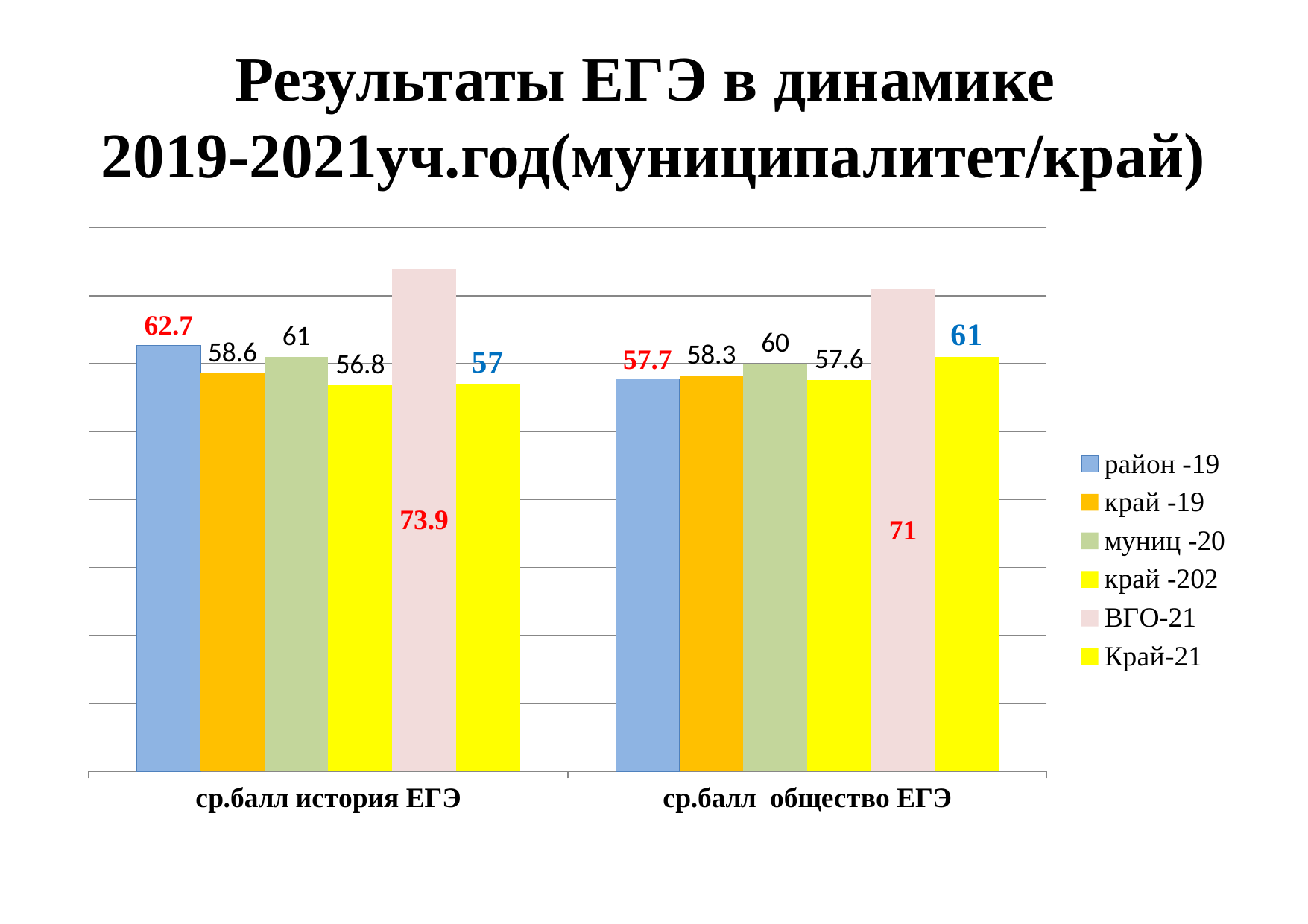
What is the value for Край-21 in the category ср.балл общество ЕГЭ? 61 Which series has the lowest value in the category ср.балл история ЕГЭ? край -202 What is the difference between the ВГО-21 values for ср.балл история ЕГЭ and ср.балл общество ЕГЭ? 2.9 What is the value for ВГО-21 in the category ср.балл история ЕГЭ? 73.9 What kind of chart is shown on the slide? bar chart Which series has the highest value in the category ср.балл история ЕГЭ? ВГО-21 What is the title of the slide? Результаты ЕГЭ в динамике 2019-2021уч.год(муниципалитет/край) What is the value for край -202 in the category ср.балл история ЕГЭ? 56.8 How many categories are shown on the x axis? 2 Which is larger: the район -19 value for ср.балл история ЕГЭ or for ср.балл общество ЕГЭ? ср.балл история ЕГЭ What is the value for район -19 in the category ср.балл общество ЕГЭ? 57.7 How many series does the legend list? 6